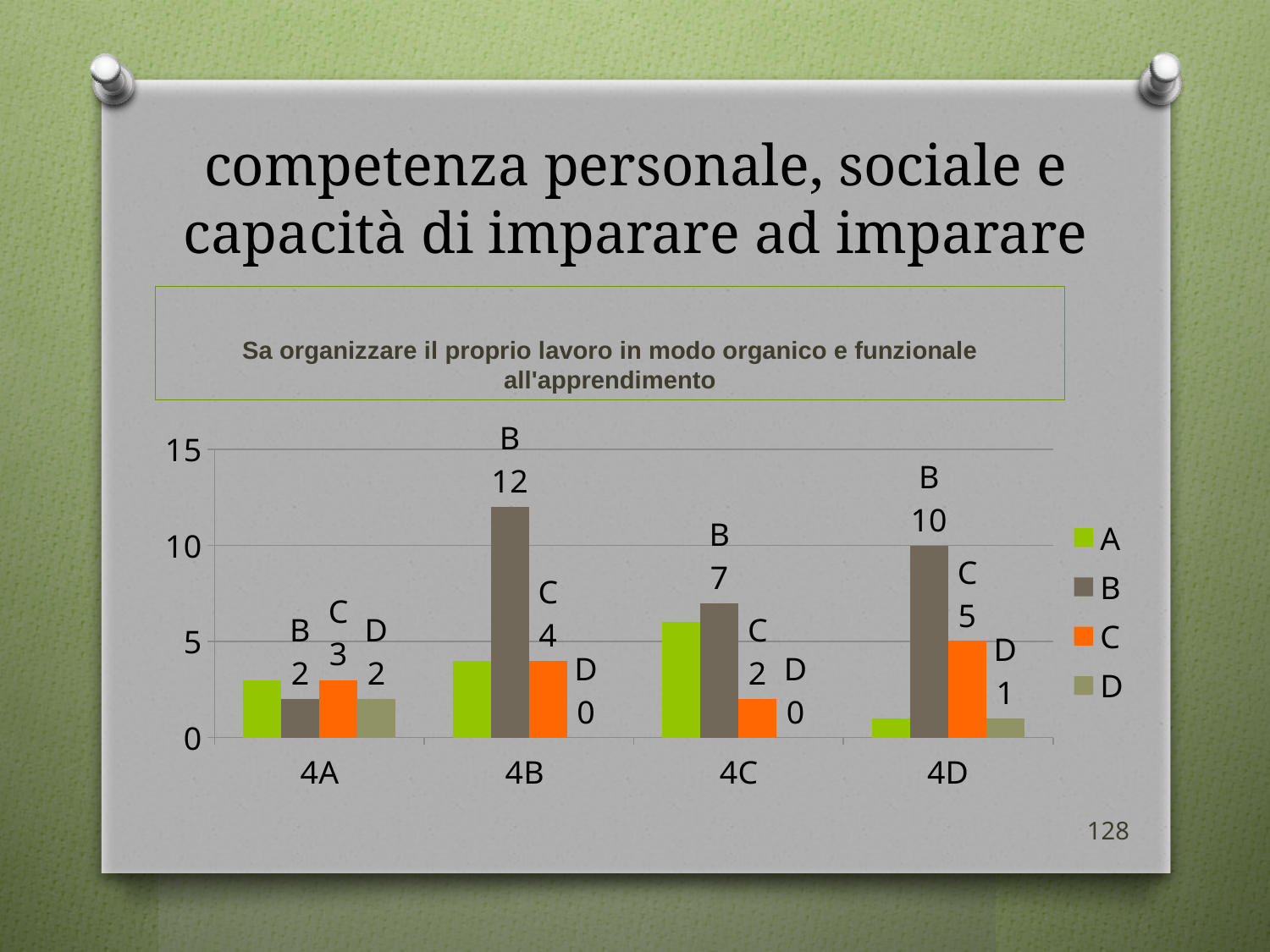
Which category has the highest value for series B? 4B How many categories are shown on the x axis? 4 What is the title of the chart? Sa organizzare il proprio lavoro in modo organico e funzionale all'apprendimento What is the value of series D for category 4B? 0 What is the value of series C for category 4D? 5 How many series does the legend list? 4 What is the value of series B for category 4B? 12 What kind of chart is shown on the slide? bar chart Is the value of series A for category 4C greater or less than 5? greater Which is larger: the series C value for 4D or the series C value for 4A? 4D Which category has the lowest value for series B? 4A What is the difference between the series B values for 4B and 4D? 2